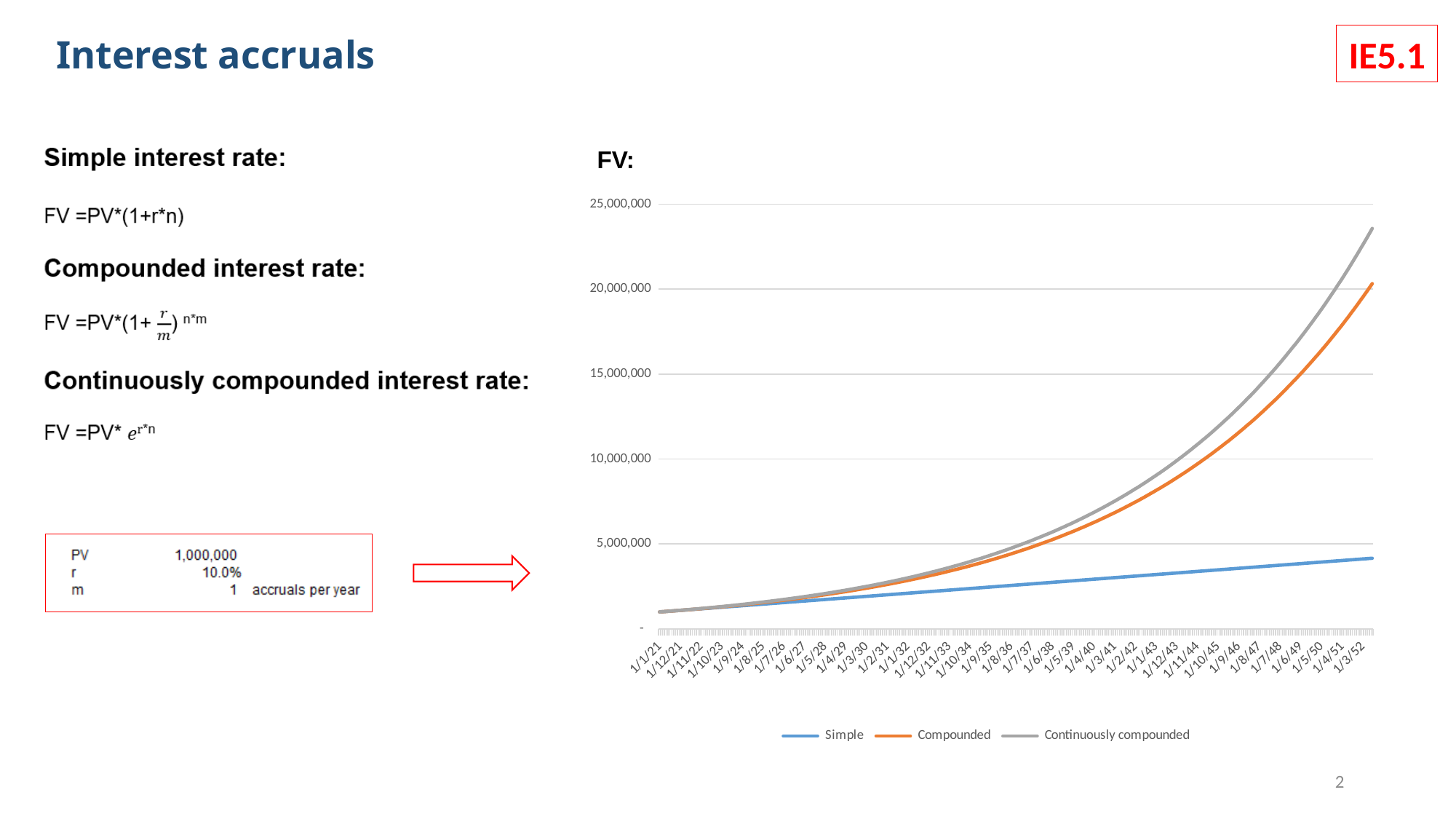
Is the value of the Continuously compounded series at 1/3/52 greater or less than 20,000,000? greater Do the values of the Continuously compounded series rise or fall from left to right along the x axis? rise What is the highest value labelled on the vertical axis of the chart? 25,000,000 Is the value of the Compounded series at 1/3/52 greater or less than 15,000,000? greater What are the three series named in the legend of the FV chart? Simple, Compounded, Continuously compounded Is the value of the Simple series at 1/3/52 greater or less than 5,000,000? less What is the title of the chart? FV: Which series has the highest value at the right end of the chart (1/3/52)? Continuously compounded What kind of chart is shown on the slide? line chart Which series has the lowest value at the right end of the chart (1/3/52)? Simple At 1/3/52, which is larger: the Compounded series or the Simple series? Compounded How many series does the legend of the FV chart list? 3